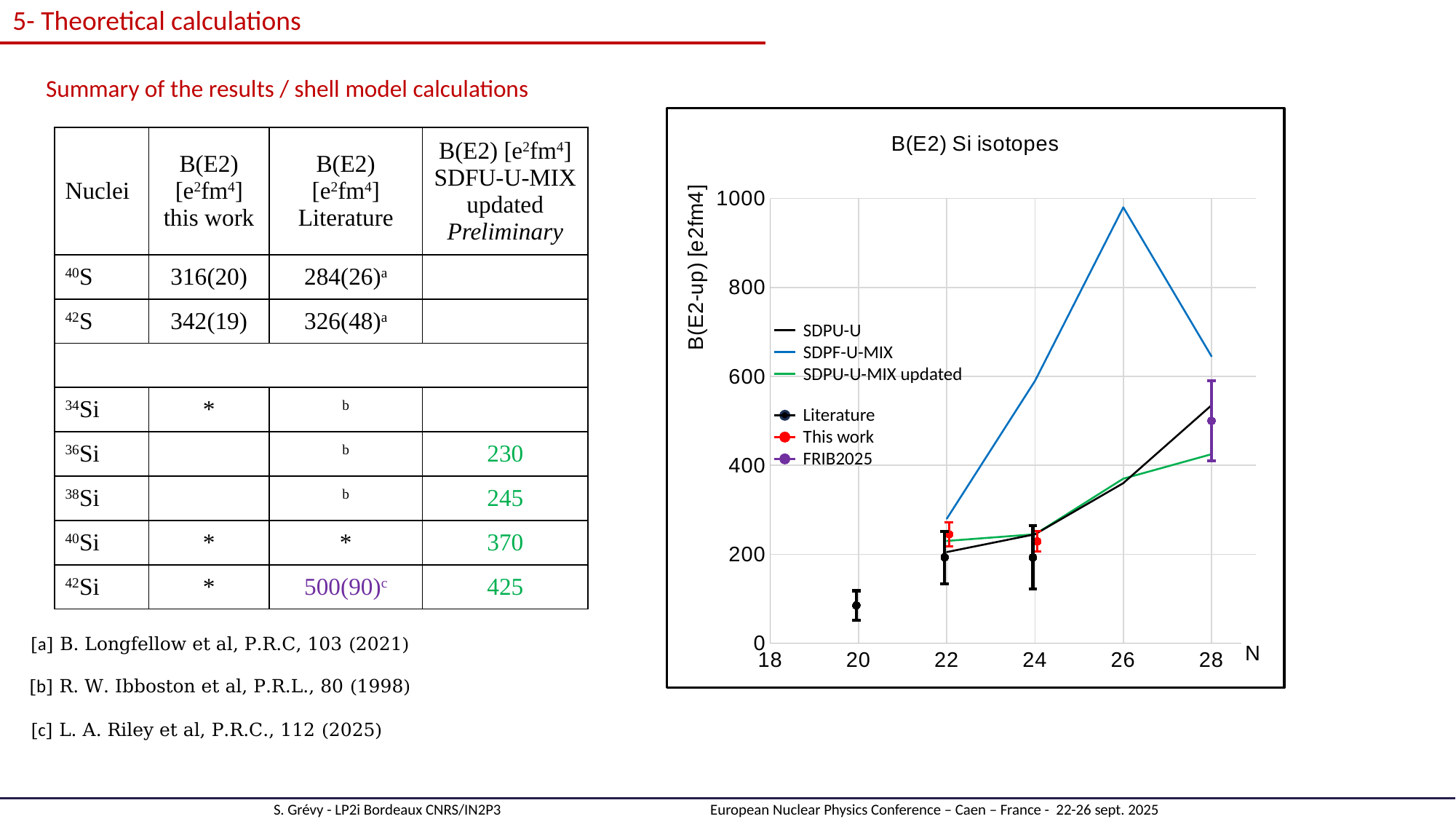
Which series reaches the highest value on the chart? SDPF-U-MIX What is the title of the chart? B(E2) Si isotopes How many FRIB2025 data points are plotted on the chart? 1 Is the FRIB2025 data point at N = 28 greater or less than 400? greater What kind of chart is shown on the slide? line chart How many series does the chart legend list? 6 Is the Literature data point at N = 20 greater or less than 200? less At N = 28, which line is higher: SDPU-U or SDPU-U-MIX updated? SDPU-U At N = 26, which line is higher: SDPF-U-MIX or SDPU-U? SDPF-U-MIX Does the SDPF-U-MIX line rise or fall between N = 26 and N = 28? fall At which value of N does the SDPF-U-MIX line reach its peak? 26 Is the value of the SDPF-U-MIX line at N = 26 greater or less than 800? greater